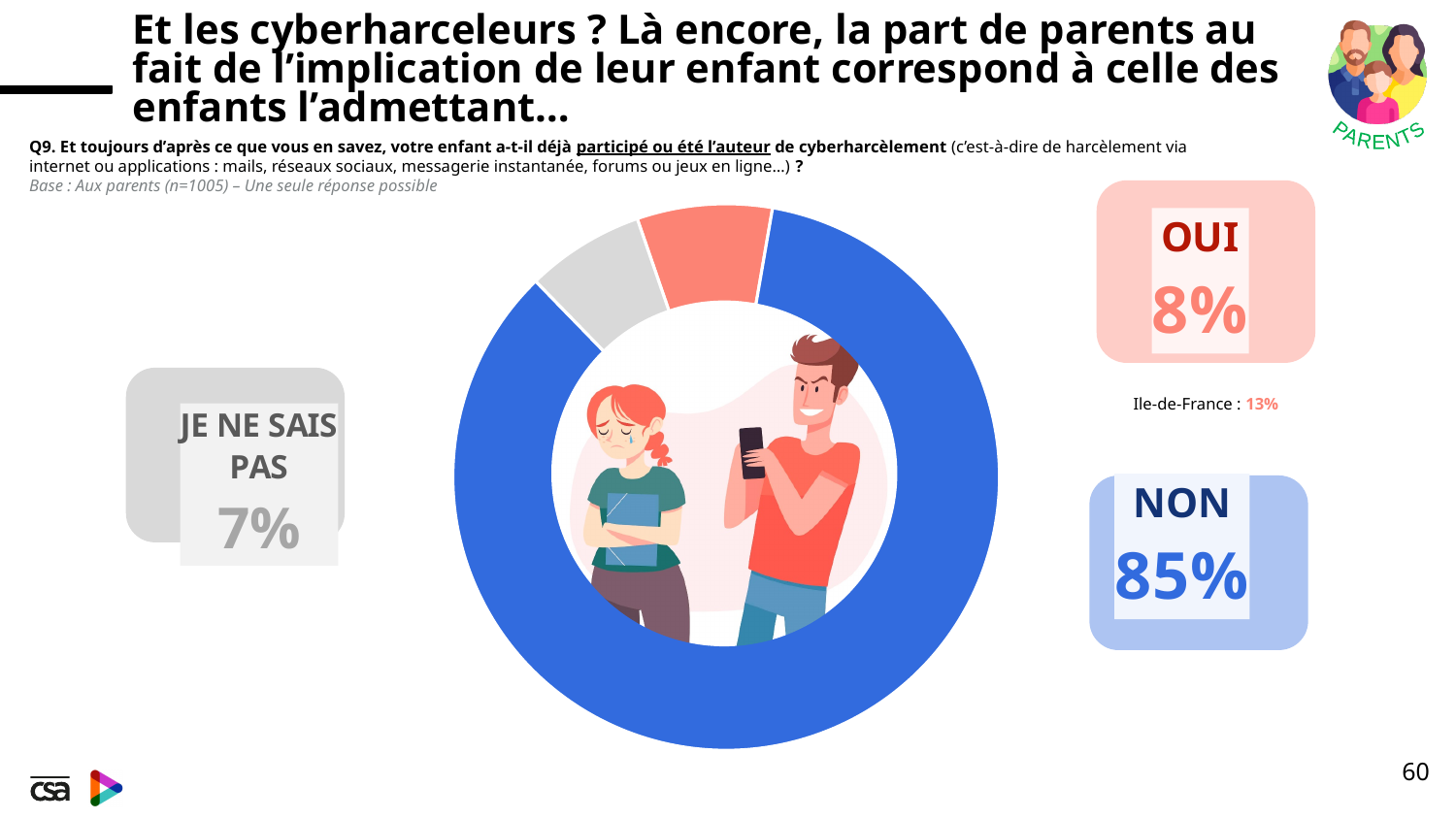
What is the difference in percentage points between "NON" and "OUI"? 77 What is the sample size (n) of parents stated in the base? 1005 Which response has the largest share of the donut chart? NON Which is larger, the share for "OUI" or the share for "JE NE SAIS PAS"? OUI What percentage of parents answered "NON"? 85% What percentage of parents answered "OUI"? 8% What is the "OUI" percentage reported for Ile-de-France? 13% What colour is the "NON" segment of the donut chart? Blue Which response has the smallest share of the donut chart? JE NE SAIS PAS How many response categories are shown in the donut chart? 3 What percentage of parents answered "JE NE SAIS PAS"? 7% What kind of chart is shown on the slide? Donut (pie) chart